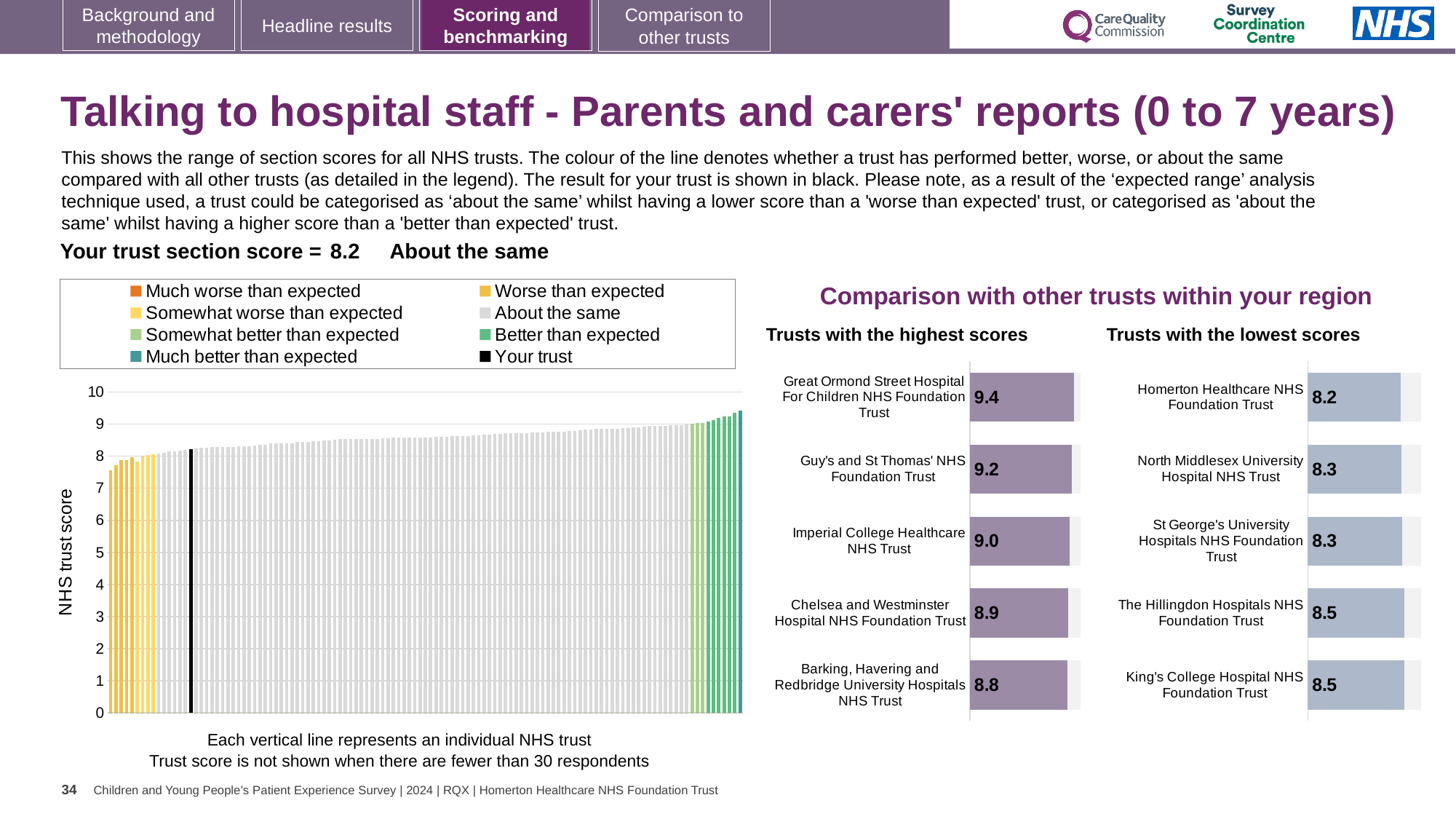
In the 'Trusts with the lowest scores' chart, what is the difference between the scores of King's College Hospital NHS Foundation Trust and Homerton Healthcare NHS Foundation Trust? 0.3 In the 'Trusts with the highest scores' chart, what is the score for Imperial College Healthcare NHS Trust? 9.0 In the 'Trusts with the highest scores' chart, what is the score for Great Ormond Street Hospital For Children NHS Foundation Trust? 9.4 What kind of chart is the main chart on the left showing NHS trust scores? Bar chart In the 'Trusts with the lowest scores' chart, which trust has the lowest score? Homerton Healthcare NHS Foundation Trust How many entries does the legend of the main NHS trust score chart list? 8 In the 'Trusts with the highest scores' chart, what is the difference between the scores of Great Ormond Street Hospital For Children NHS Foundation Trust and Guy's and St Thomas' NHS Foundation Trust? 0.2 Which has the higher score: Chelsea and Westminster Hospital NHS Foundation Trust in the highest scores chart, or North Middlesex University Hospital NHS Trust in the lowest scores chart? Chelsea and Westminster Hospital NHS Foundation Trust In the 'Trusts with the highest scores' chart, which trust has the lowest score shown? Barking, Havering and Redbridge University Hospitals NHS Trust In the 'Trusts with the lowest scores' chart, what is the score for The Hillingdon Hospitals NHS Foundation Trust? 8.5 In the main NHS trust score chart, do the values rise or fall from left to right? Rise How many trusts are shown in the 'Trusts with the highest scores' chart? 5